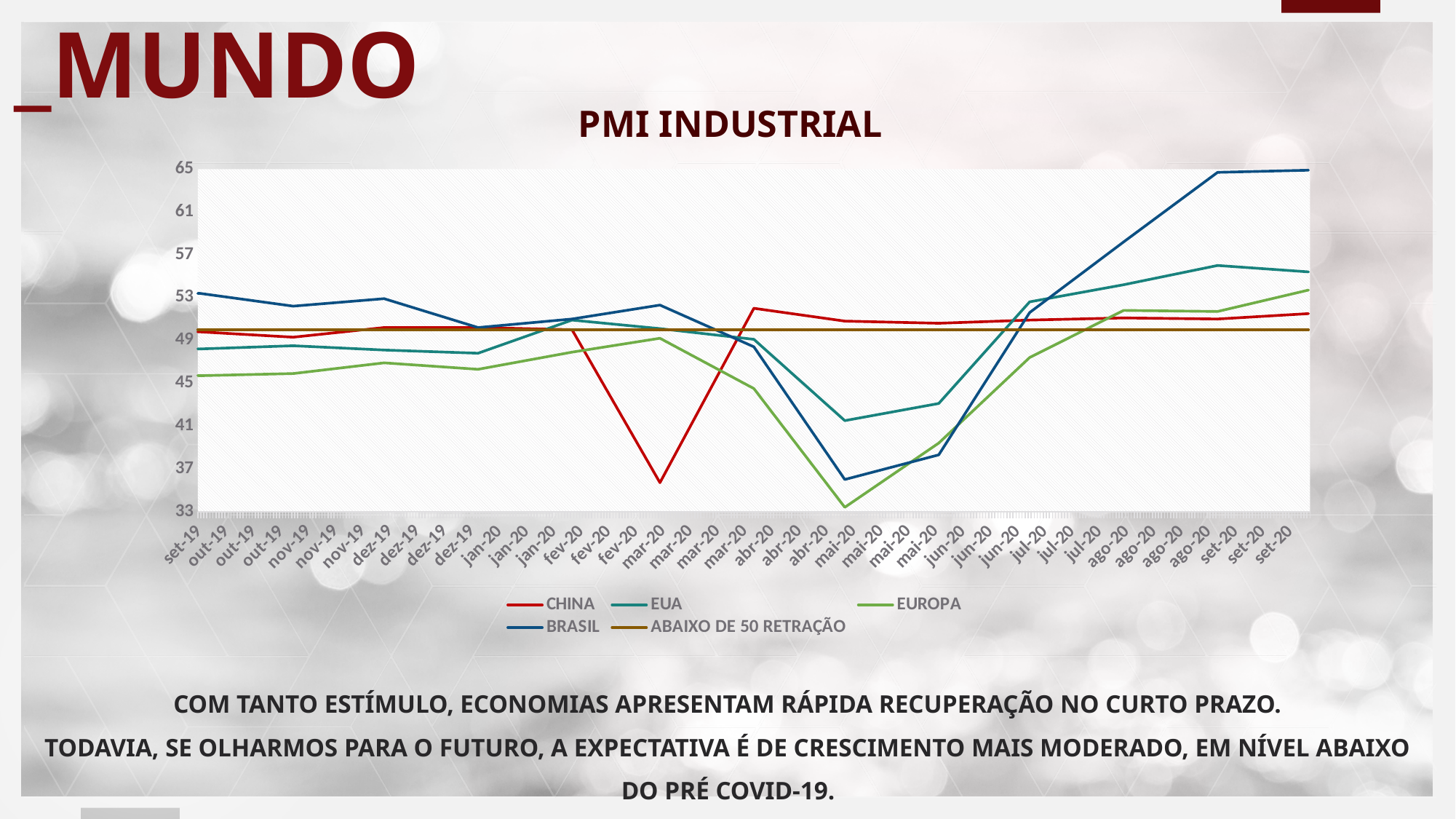
What colour is the CHINA line in the chart? red How many series does the chart legend list? 5 Is the lowest value of the CHINA line greater or less than 37? less What kind of chart is shown on the slide? line chart Is the lowest value of the EUA line greater or less than 45? less Is the value of the EUA line at set-20 greater or less than 53? greater What is the title of the chart? PMI INDUSTRIAL At set-20, which series has the larger value, BRASIL or CHINA? BRASIL Which series reaches the lowest value on the chart? EUROPA Does the BRASIL line rise or fall between jun-20 and set-20? rise Which series reaches the highest value on the chart? BRASIL